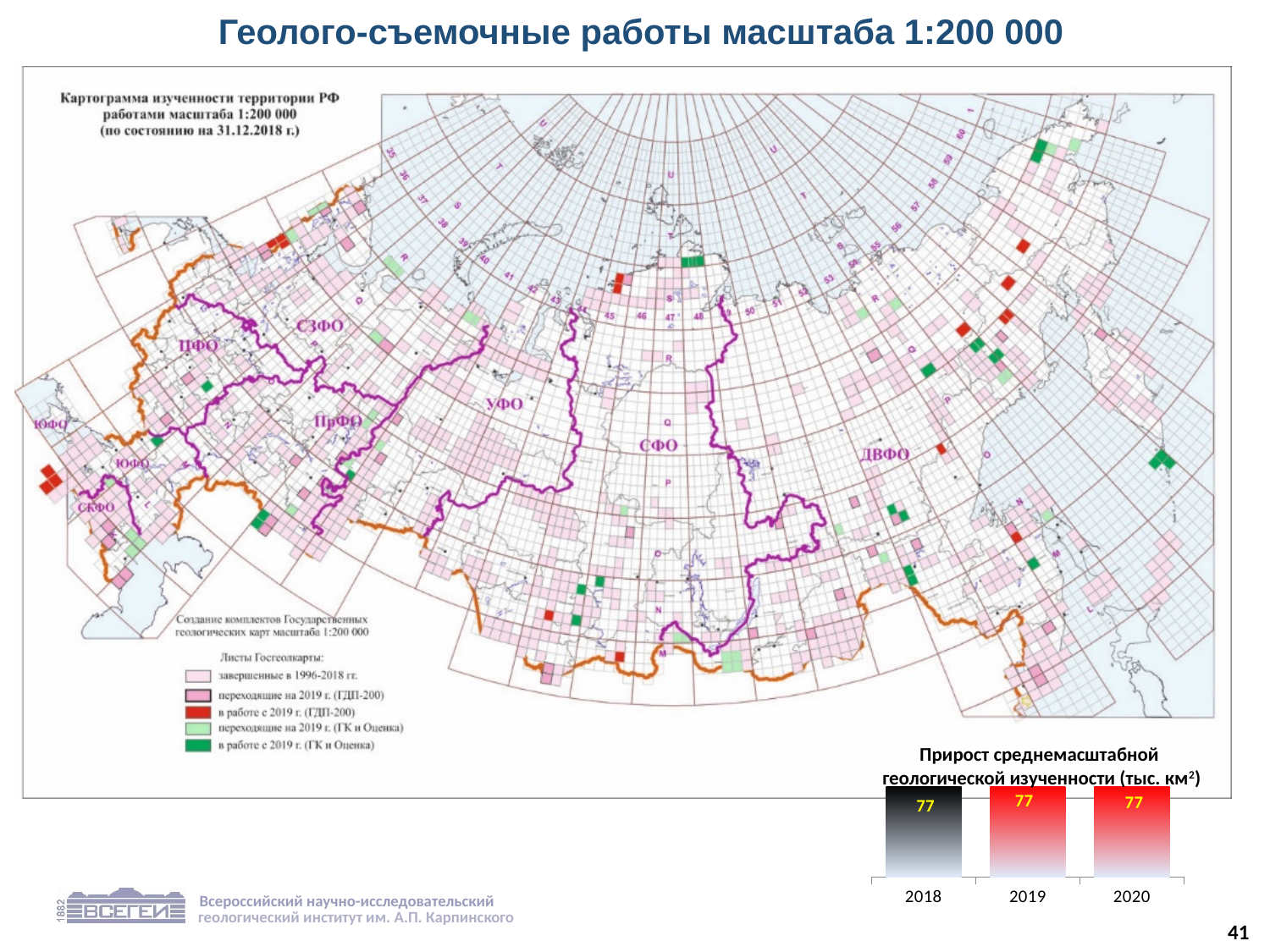
In the bar chart at the bottom right, do the values rise, fall or stay the same from 2018 to 2020? stay the same What is the first year shown on the x axis of the bar chart at the bottom right? 2018 What is the value for 2019 in the bar chart at the bottom right of the slide? 77 What is the last year shown on the x axis of the bar chart at the bottom right? 2020 What is the value for 2018 in the bar chart at the bottom right of the slide? 77 In the bar chart at the bottom right, what is the difference between the values for 2019 and 2018? 0 What kind of chart is shown at the bottom right of the slide? bar chart What is the value for 2020 in the bar chart at the bottom right of the slide? 77 What is the title of the bar chart at the bottom right of the slide? Прирост среднемасштабной геологической изученности (тыс. км²) In the bar chart at the bottom right, is the value for 2020 larger than, smaller than or equal to the value for 2018? equal In the bar chart at the bottom right, which year's bar is coloured black rather than red? 2018 How many years are shown on the x axis of the bar chart at the bottom right of the slide? 3